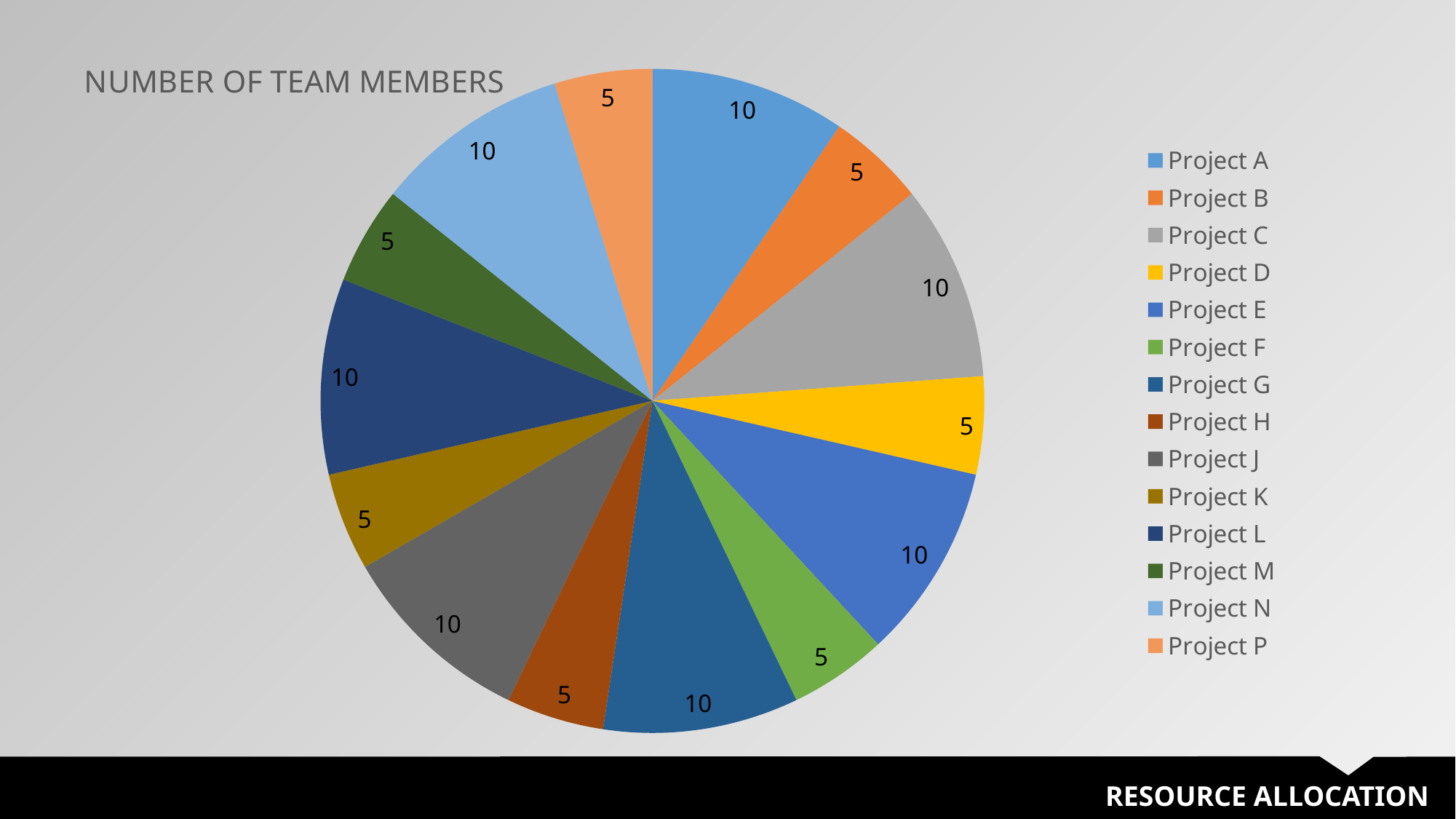
How many team members are allocated to Project H? 5 What kind of chart is shown on the slide? pie chart Which has more team members, Project E or Project F? Project E How many projects (slices) does the pie chart show? 14 What is the title of the chart? NUMBER OF TEAM MEMBERS What is the total number of team members across all projects in the pie chart? 105 What colour is the slice for Project D? yellow What is the difference in team members between Project C and Project B? 5 How many team members are allocated to Project P? 5 How many team members are allocated to Project L? 10 How many team members are allocated to Project D? 5 How many team members are allocated to Project A? 10